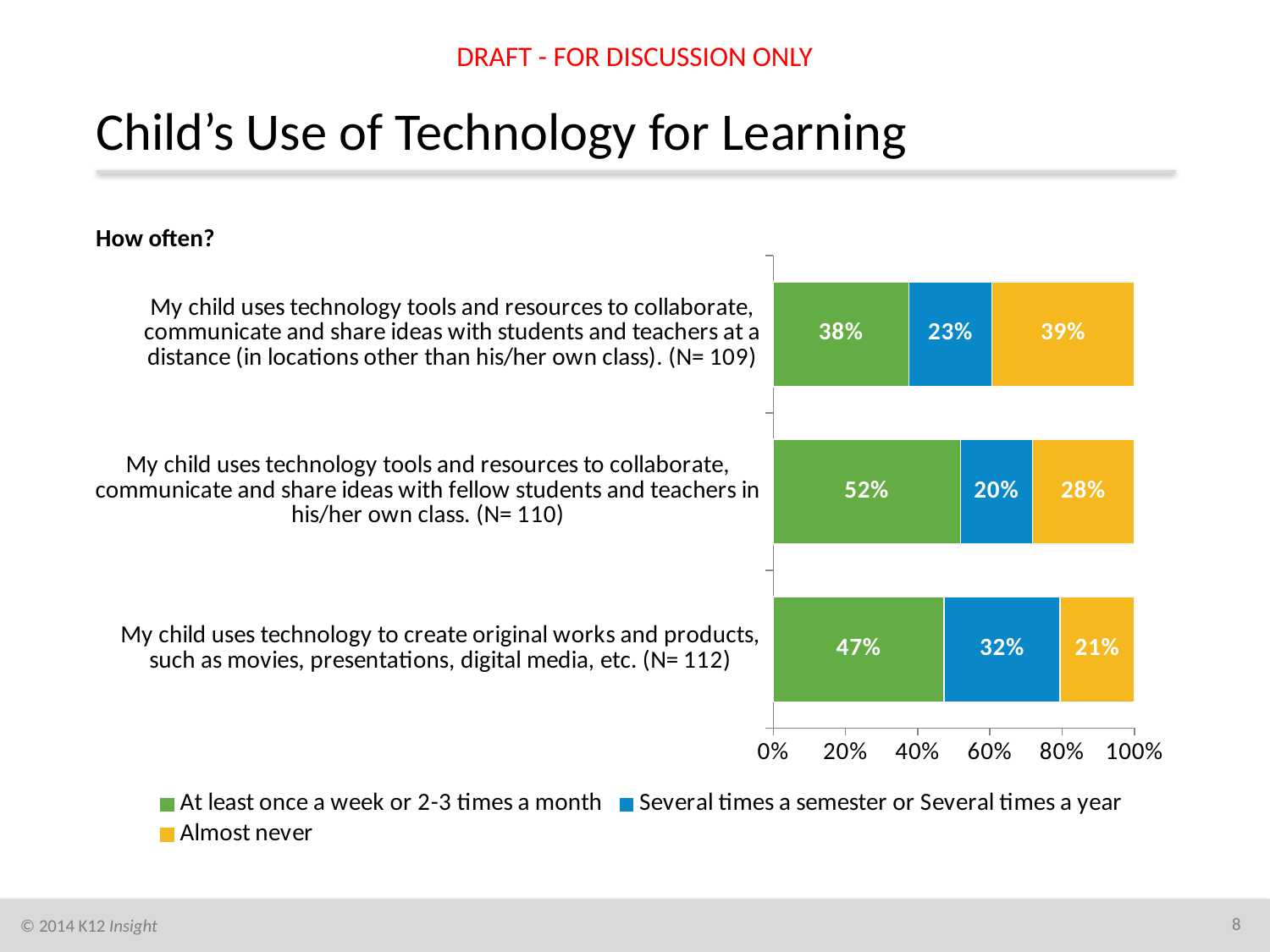
What percentage answered 'Almost never' for the item about collaborating with students and teachers at a distance (N= 109)? 39% What is the difference between the 'Almost never' percentages for the distance collaboration item (N= 109) and the create original works item (N= 112)? 18 percentage points Which item has the highest percentage for 'At least once a week or 2-3 times a month'? My child uses technology tools and resources to collaborate, communicate and share ideas with fellow students and teachers in his/her own class. (N= 110) What is the total of the three segments in the bar for the own-class collaboration item (N= 110)? 100% Which item has the lowest percentage for 'Almost never'? My child uses technology to create original works and products, such as movies, presentations, digital media, etc. (N= 112) Which colour represents 'Almost never' in the chart? Yellow How many survey items (bars) are shown in the chart? 3 How many series does the legend list? 3 What percentage answered 'Several times a semester or Several times a year' for the item about collaborating with fellow students and teachers in his/her own class (N= 110)? 20% Which is larger: the 'Several times a semester or Several times a year' share for the create original works item (N= 112) or for the distance collaboration item (N= 109)? The create original works item (N= 112) What type of chart is shown on the slide? Stacked horizontal bar chart What percentage of parents said their child uses technology to create original works and products at least once a week or 2-3 times a month? 47%